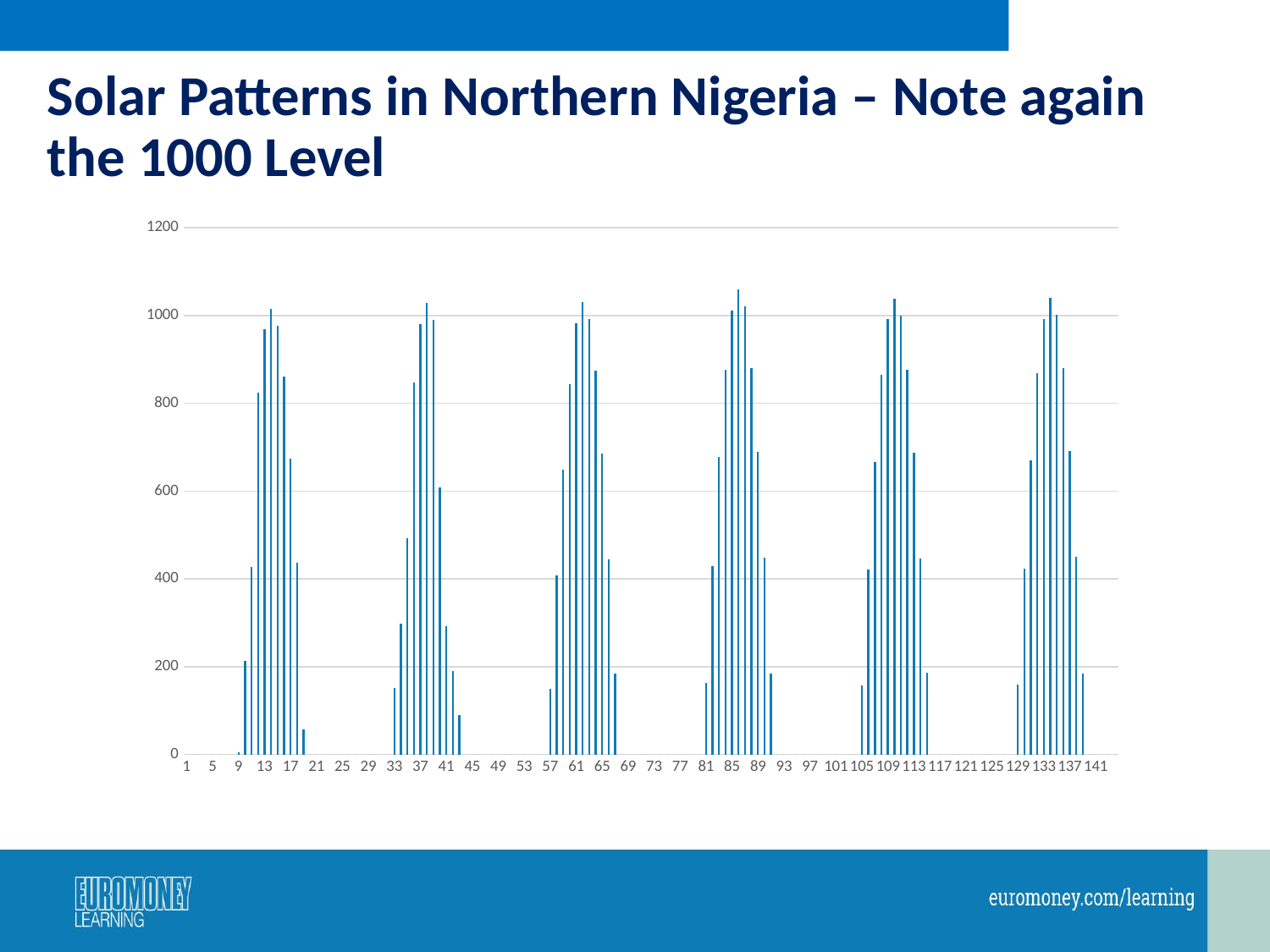
Do any bars in the chart rise above the 1000 level on the vertical axis? Yes Which is larger, the value for category 13 or the value for category 9? category 13 Is the value for category 33 greater or less than 400? less Is the value for category 17 greater or less than 800? less How many separate clusters (peaks) of bars appear across the chart? 6 What is the last label shown on the horizontal axis? 141 What kind of chart is shown on the slide? bar chart What is the highest value shown on the vertical axis? 1200